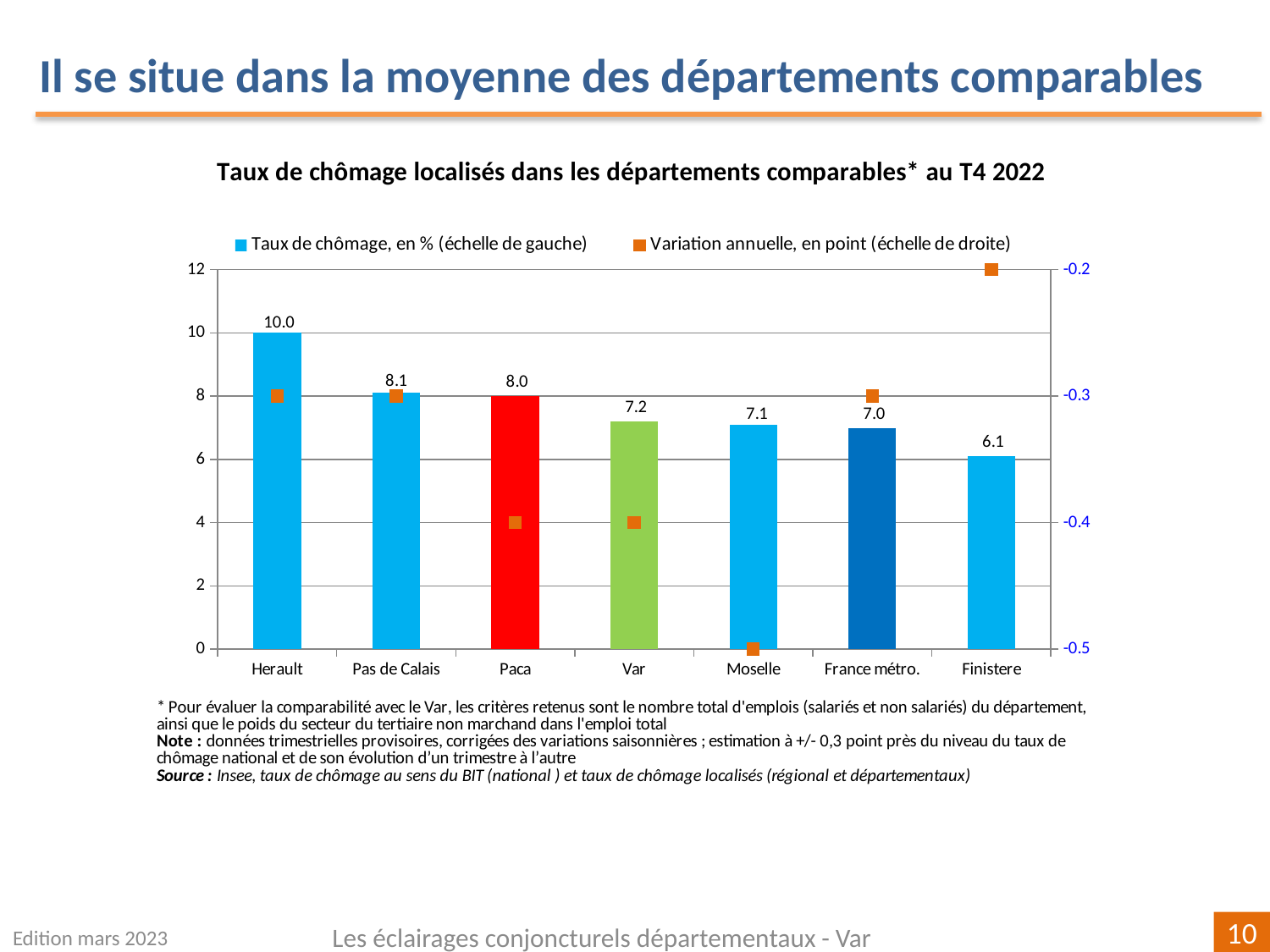
What is the annual variation in points (right axis) shown for Moselle? -0.5 How many series does the chart legend list? 2 Which department has the lowest unemployment rate in the chart? Finistere How many departments or areas are shown on the x axis of the chart? 7 What is the annual variation in points (right axis) shown for Finistere? -0.2 What is the unemployment rate (taux de chômage) shown for Herault? 10.0 What is the unemployment rate shown for France métro.? 7.0 Which department has the highest unemployment rate in the chart? Herault What is the unemployment rate shown for Var? 7.2 Which has a higher unemployment rate, Pas de Calais or Var? Pas de Calais What is the difference between the unemployment rates of Herault and Finistere? 3.9 What is the title of the chart? Taux de chômage localisés dans les départements comparables* au T4 2022